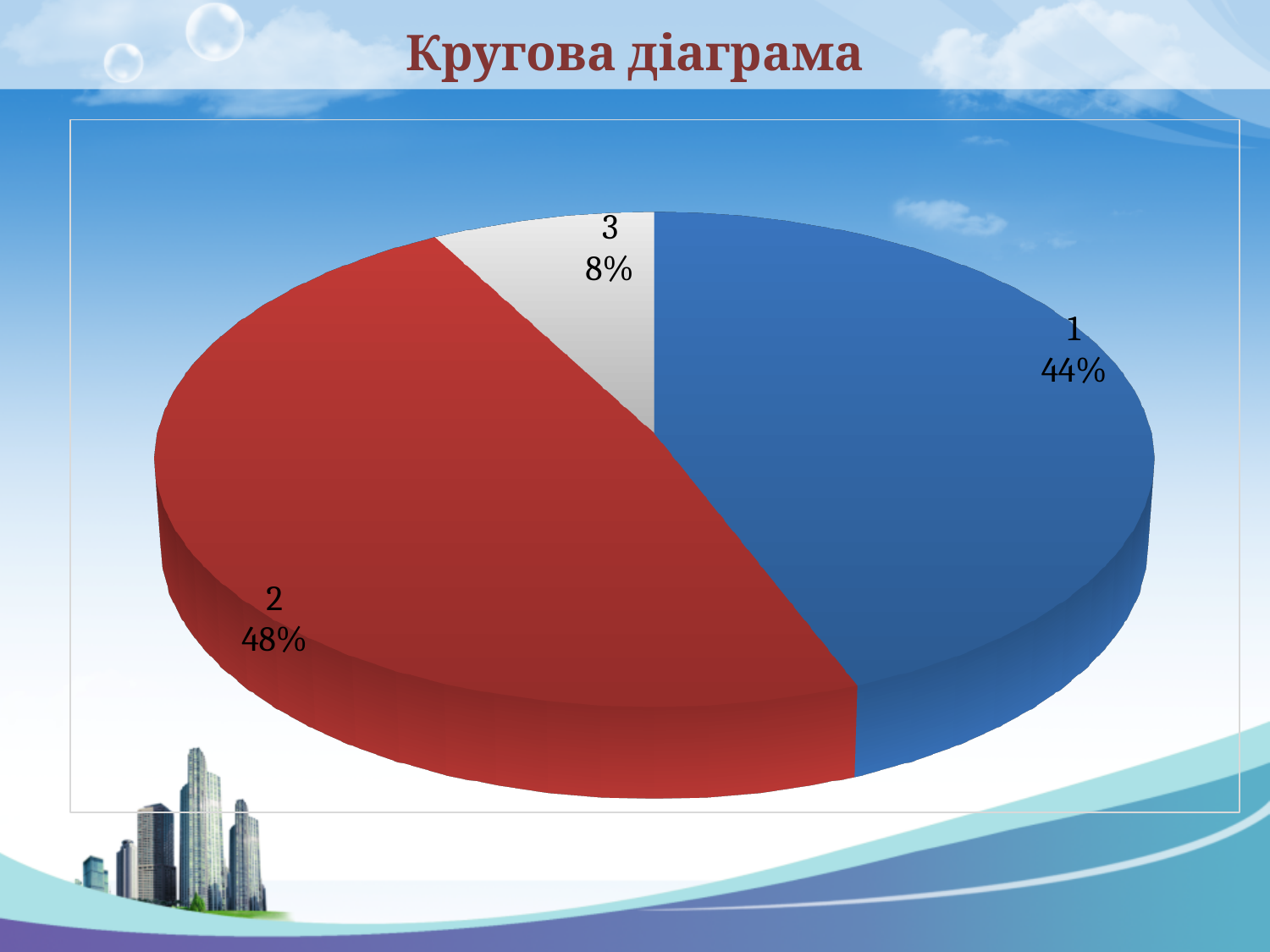
What percentage is shown for slice 1? 44% Which slice has the largest share of the pie? 2 Which is larger, the share of slice 1 or the share of slice 3? slice 1 What kind of chart is shown on the slide? pie chart What percentage is shown for slice 3? 8% What colour is the slice labelled 2? red What is the title of the slide? Кругова діаграма What is the difference in percentage points between slice 2 and slice 1? 4 How many slices does the pie chart have? 3 Which slice has the smallest share of the pie? 3 What percentage is shown for slice 2? 48% What is the difference in percentage points between slice 1 and slice 3? 36